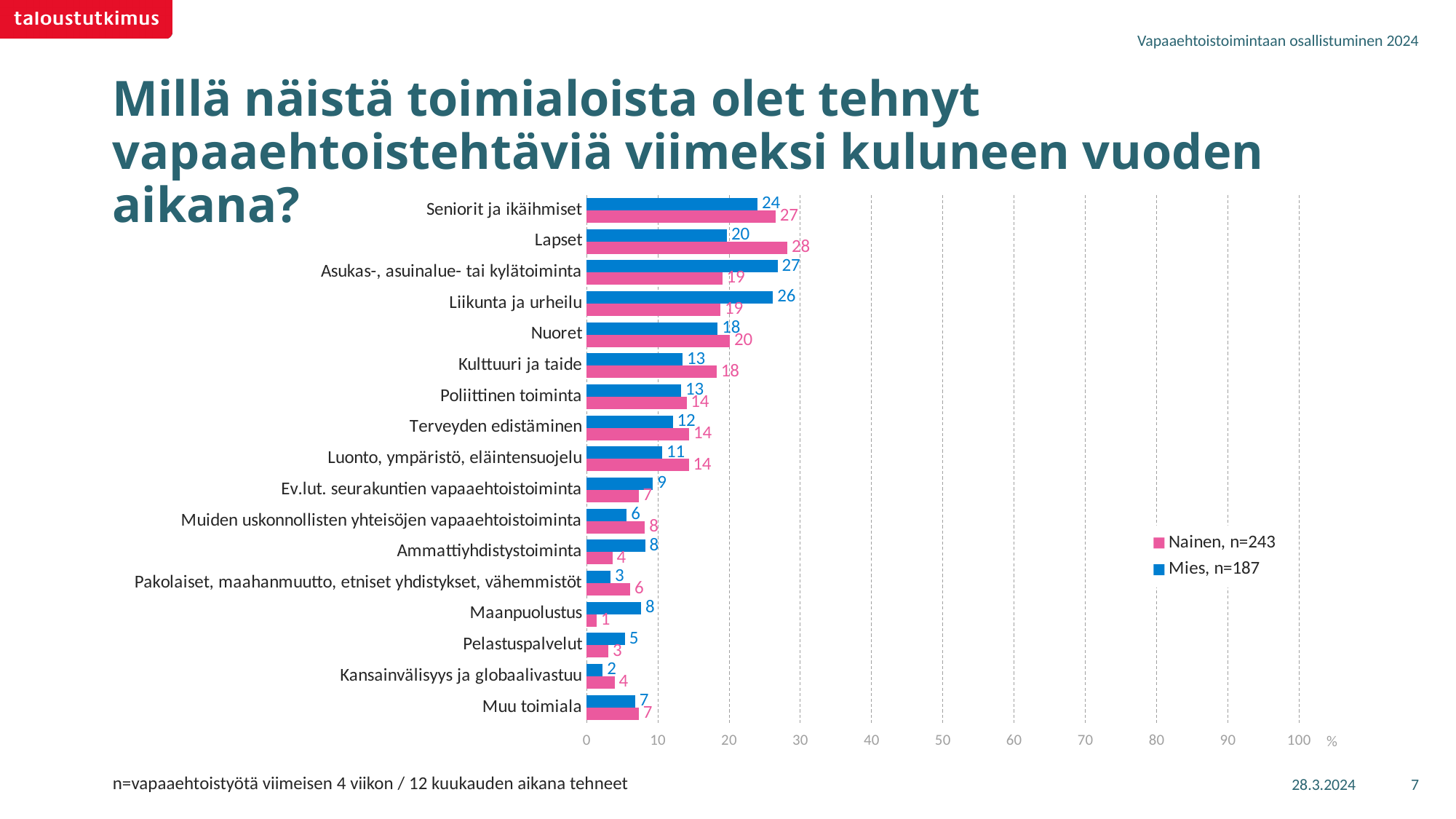
What is the value for Nainen for Kulttuuri ja taide? 18 What is the difference between the Mies and Nainen values for Maanpuolustus? 7 What is the value for Nainen (women) for Lapset? 28 Which category has the highest value for Nainen? Lapset Which category has the highest value for Mies? Asukas-, asuinalue- tai kylätoiminta For Liikunta ja urheilu, which is larger: the Mies value or the Nainen value? Mies How many series does the legend list? 2 Is the Nainen value for Lapset greater or less than 20? greater What is the value for Mies (men) for Seniorit ja ikäihmiset? 24 What kind of chart is shown on the slide? Bar chart Which category has the lowest value for Nainen? Maanpuolustus How many categories are shown on the chart? 17